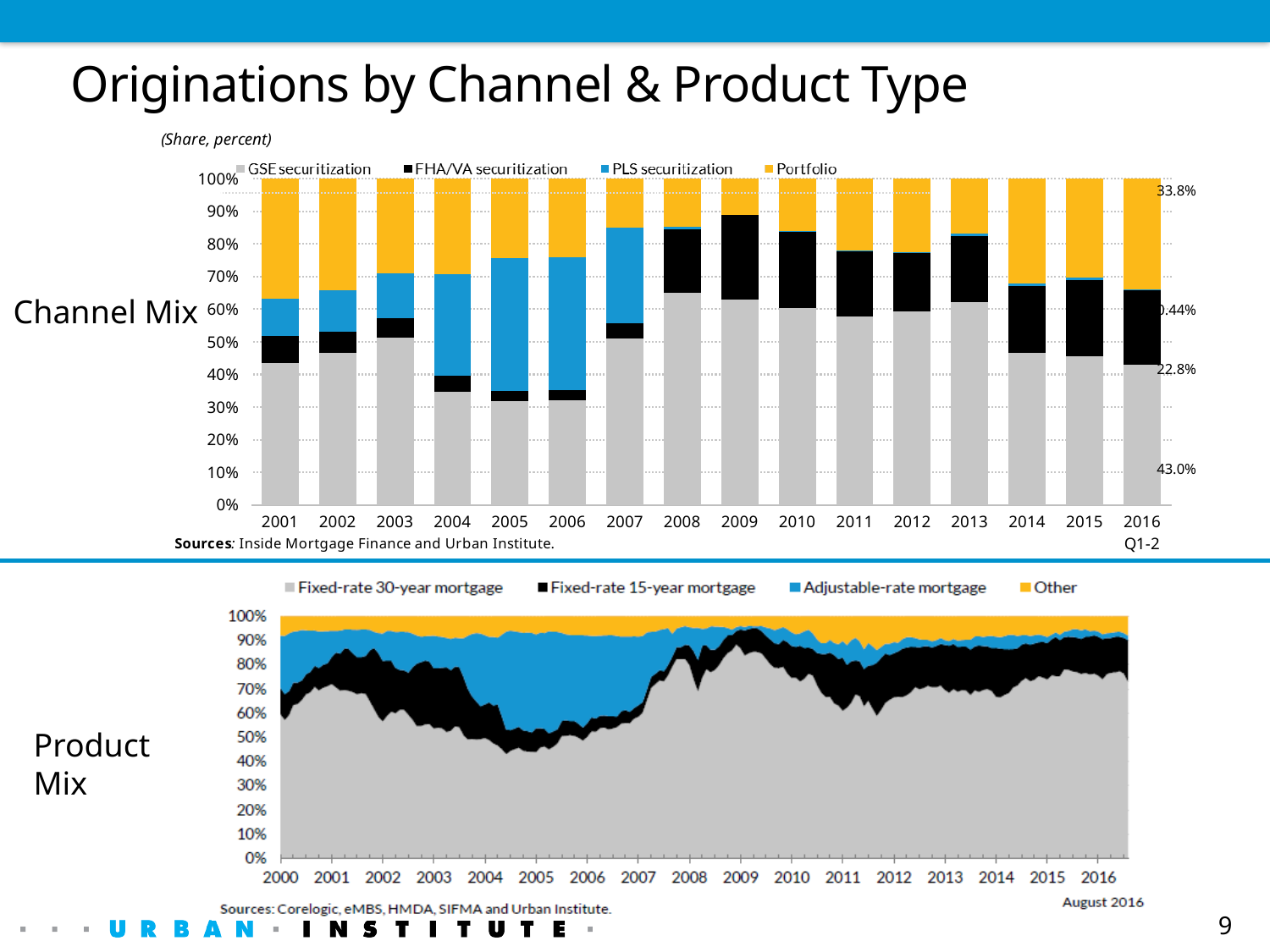
On the Product Mix chart, is the Fixed-rate 30-year mortgage share in 2016 greater or less than 70%? greater What kind of chart is the Product Mix chart? Stacked area chart On the Channel Mix chart, what is the Portfolio share for 2016 Q1-2? 33.8% On the Channel Mix chart, is the GSE securitization share in 2005 greater or less than 40%? less On the Channel Mix chart, what is the PLS securitization share for 2016 Q1-2? 0.44% On the Channel Mix chart, how many bars (years) are plotted? 16 On the Channel Mix chart, what is the GSE securitization share for 2016 Q1-2? 43.0% On the Channel Mix chart, which year has the larger PLS securitization share, 2005 or 2012? 2005 On the Product Mix chart, how many series does the legend list? 4 On the Channel Mix chart, what is the FHA/VA securitization share for 2016 Q1-2? 22.8% On the Channel Mix chart, how many series does the legend list? 4 What kind of chart is the Channel Mix chart? Stacked bar chart